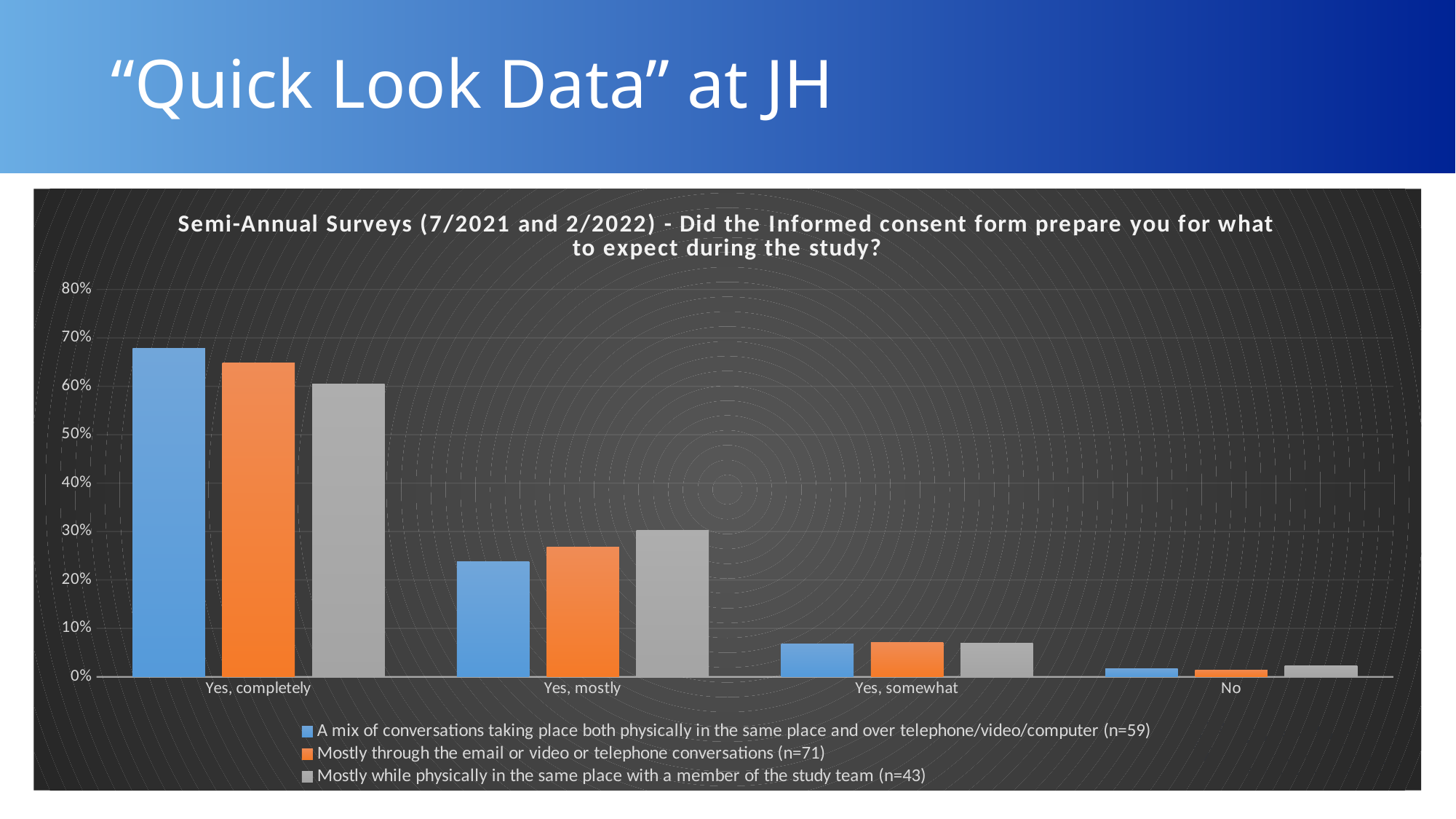
What kind of chart is shown on the slide? bar chart Do the values rise or fall moving from 'Yes, completely' to 'No' along the x axis? fall Is the value for 'Yes, mostly' in the 'Mostly while physically in the same place with a member of the study team (n=43)' series greater or less than 40%? less Is the value for 'Yes, somewhat' in the 'Mostly through the email or video or telephone conversations (n=71)' series greater or less than 10%? less Is the value for 'Yes, completely' in the 'A mix of conversations taking place both physically in the same place and over telephone/video/computer (n=59)' series greater or less than 60%? greater How many response categories are shown on the x axis? 4 Which response category has the highest values across all three series? Yes, completely For 'Yes, mostly', which series has the larger value: 'A mix of conversations taking place both physically in the same place and over telephone/video/computer (n=59)' or 'Mostly while physically in the same place with a member of the study team (n=43)'? Mostly while physically in the same place with a member of the study team (n=43) For 'Yes, completely', which series has the larger value: 'A mix of conversations taking place both physically in the same place and over telephone/video/computer (n=59)' or 'Mostly while physically in the same place with a member of the study team (n=43)'? A mix of conversations taking place both physically in the same place and over telephone/video/computer (n=59) How many series does the legend list? 3 Which response category has the lowest values across all three series? No What colour represents the 'Mostly through the email or video or telephone conversations (n=71)' series? orange